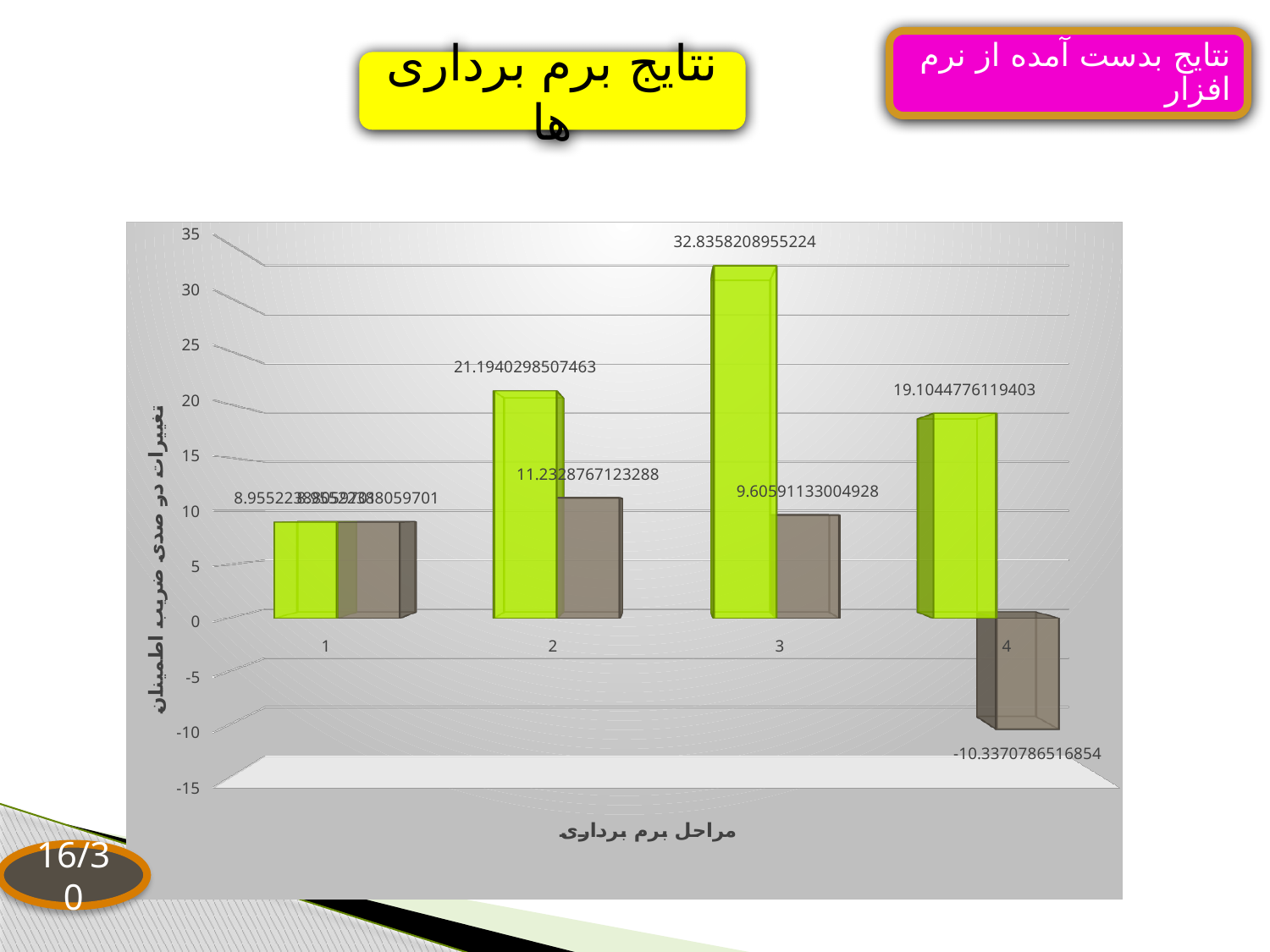
What is the value of the brown bar for category 4? -10.3370786516854 Which category has the lowest brown bar? 4 Which category has the highest green bar? 3 What kind of chart is shown on the slide? bar chart How many categories are shown on the x axis? 4 What is the value of the brown bar for category 3? 9.60591133004928 What is the value of the green bar for category 4? 19.1044776119403 For category 3, which bar is larger, the green one or the brown one? the green one What is the value of the brown bar for category 2? 11.2328767123288 What is the difference between the green bar values for category 3 and category 2? 11.6417910447761 What is the value of the green bar for category 2? 21.1940298507463 What is the value of the green bar for category 3? 32.8358208955224